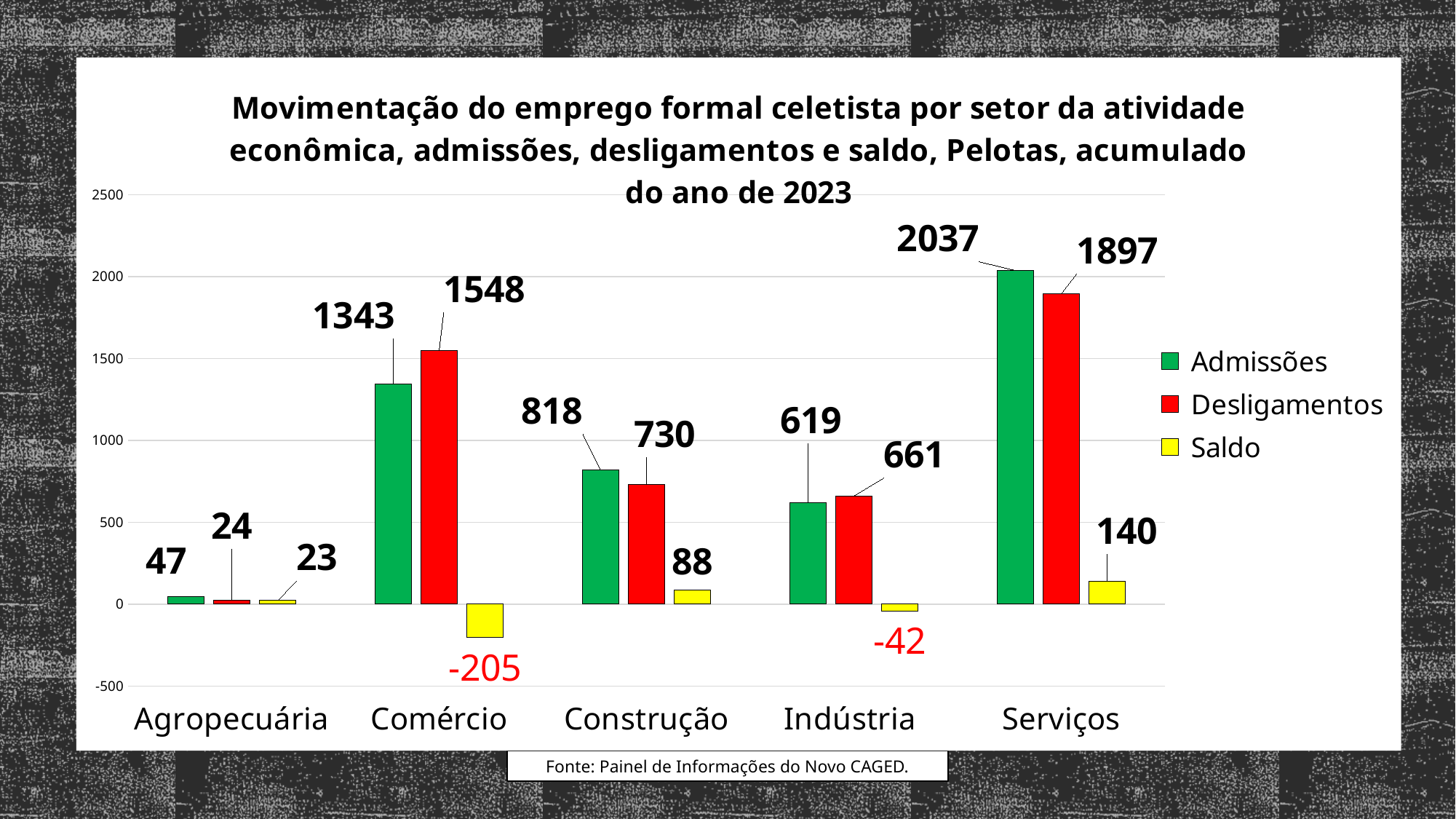
Is the Desligamentos value for Serviços greater or less than 1500? greater What is the difference between Admissões and Desligamentos for Construção? 88 Which sector has the lowest Saldo value? Comércio What is the Saldo value for Indústria? -42 What colour represents the Saldo series in the legend? Yellow What kind of chart is shown on the slide? Bar chart How many series does the legend list? 3 What is the Desligamentos value for Comércio? 1548 What is the Admissões value for Serviços? 2037 How many sectors are shown on the x axis? 5 Which sector has the highest Admissões value? Serviços Which is larger for Comércio, Admissões or Desligamentos? Desligamentos